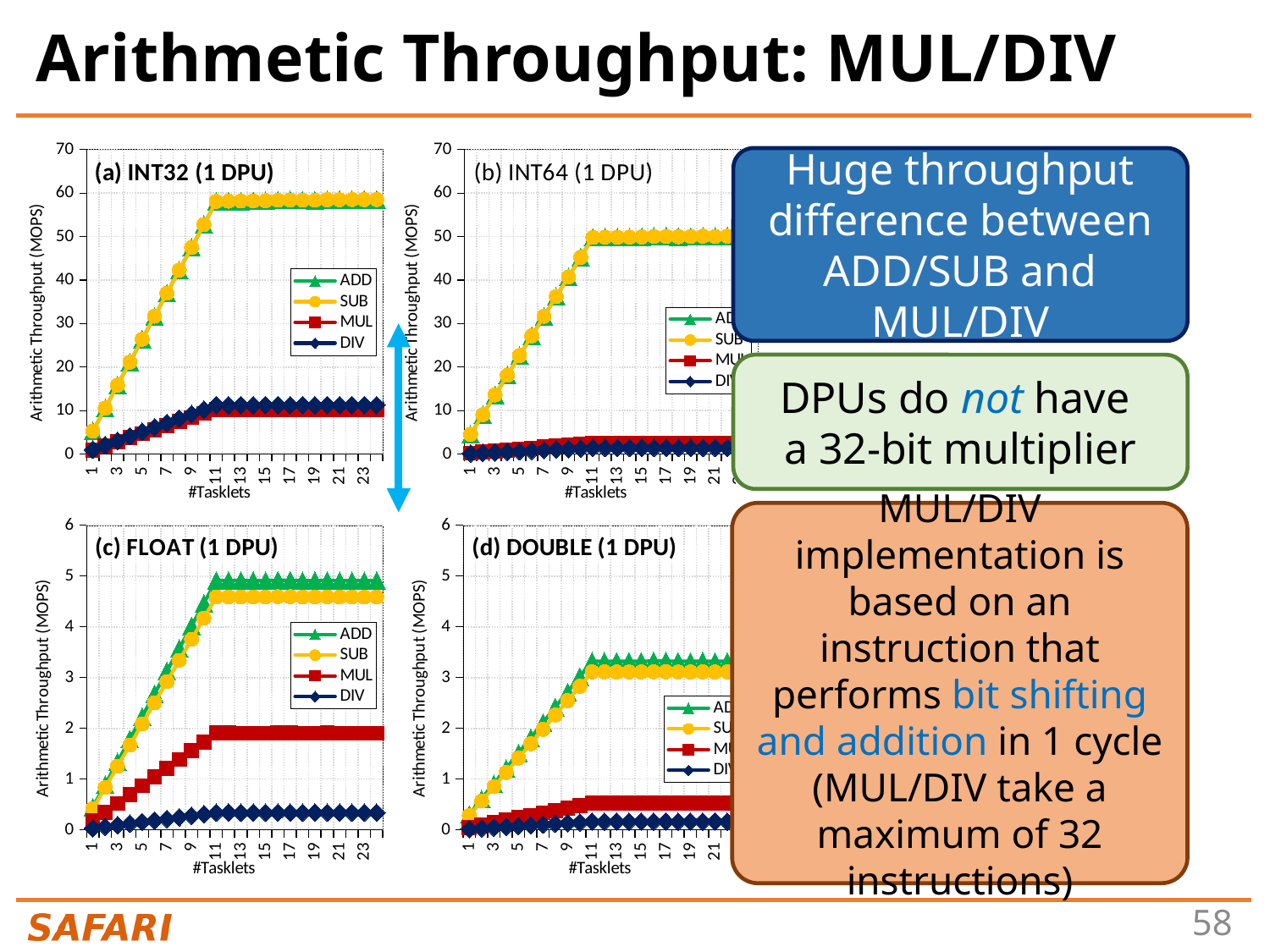
In chart (c) FLOAT (1 DPU), is the MUL throughput at 23 tasklets greater or less than 1? greater In chart (b) INT64 (1 DPU), is the SUB throughput at 21 tasklets greater or less than 40? greater In chart (d) DOUBLE (1 DPU), is the MUL throughput at 21 tasklets greater or less than 1? less What is the x-axis label of chart (b) INT64 (1 DPU)? #Tasklets In chart (d) DOUBLE (1 DPU), which is larger at 21 tasklets, the ADD throughput or the DIV throughput? ADD In chart (a) INT32 (1 DPU), does the ADD throughput rise or fall as the number of tasklets increases from 1 to 11? rise What is the y-axis label of chart (c) FLOAT (1 DPU)? Arithmetic Throughput (MOPS) In chart (c) FLOAT (1 DPU), which series has the lowest throughput at 23 tasklets? DIV How many series does the legend of chart (c) FLOAT (1 DPU) list? 4 What kind of chart is chart (a) INT32 (1 DPU)? line chart